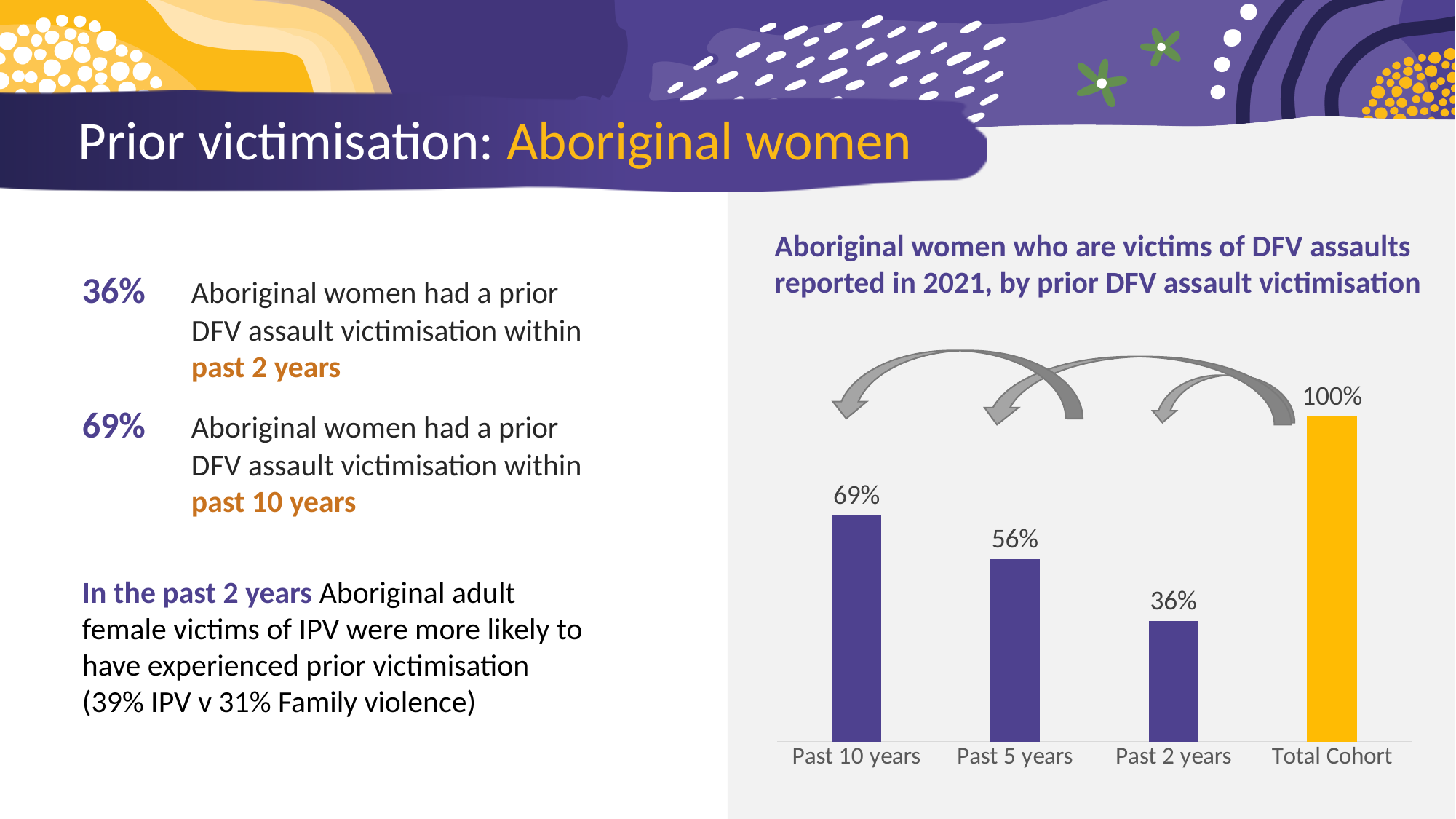
What is the title of the chart? Aboriginal women who are victims of DFV assaults reported in 2021, by prior DFV assault victimisation What is the value for Past 2 years? 36% Which is larger, the value for Past 10 years or Past 5 years? Past 10 years Which category has the lowest value? Past 2 years What is the difference between the values for Past 10 years and Past 2 years? 33% What kind of chart is shown? Bar chart Which category has the highest value? Total Cohort How many categories are shown on the chart? 4 What is the value for Total Cohort? 100% What is the value for Past 10 years? 69% What is the value for Past 5 years? 56% What is the difference between the values for Past 5 years and Past 2 years? 20%